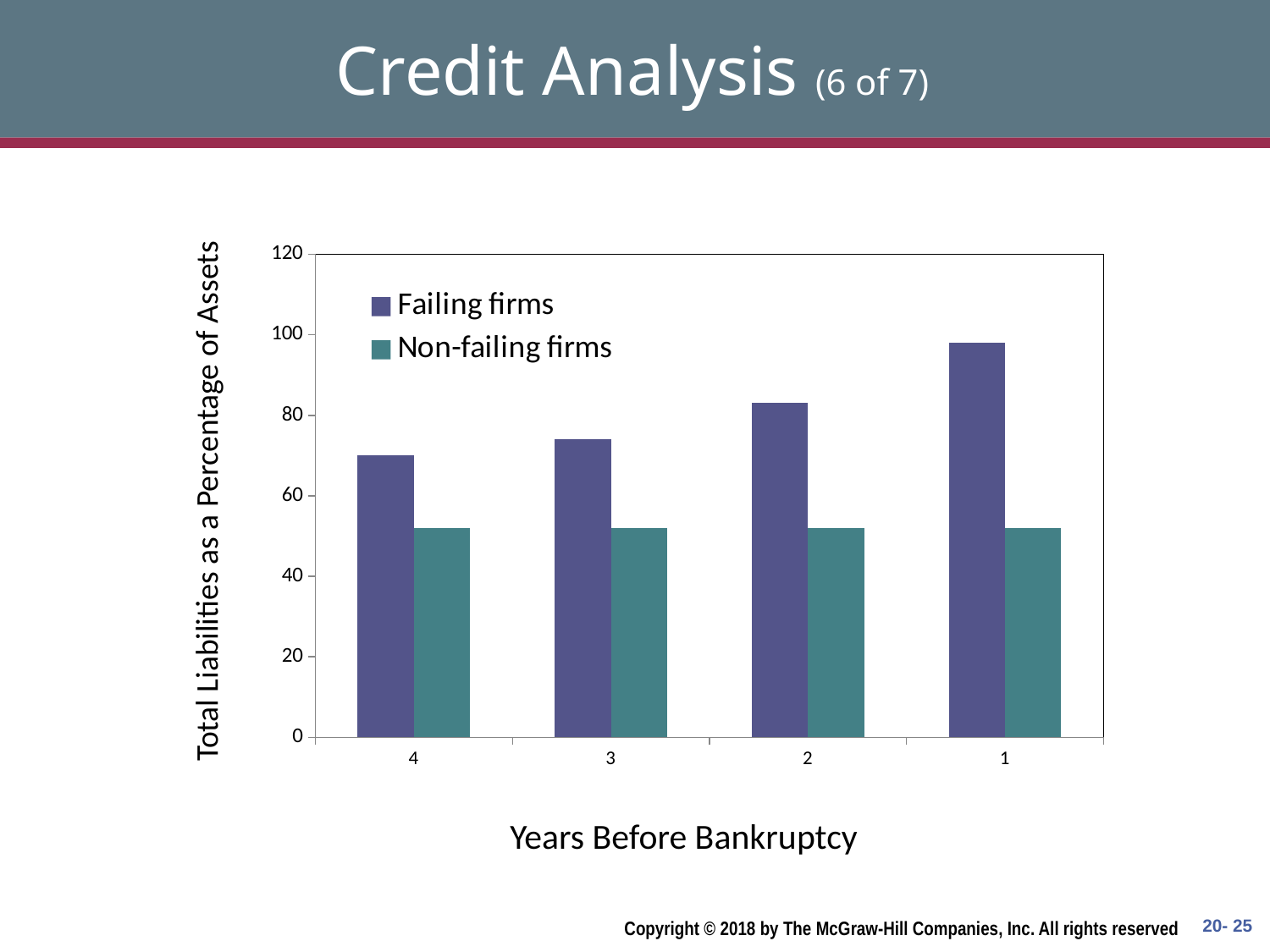
At 2 years before bankruptcy, which series has the larger value, Failing firms or Non-failing firms? Failing firms For Failing firms, which year before bankruptcy has the lowest value? 4 Is the value for Non-failing firms at 4 years before bankruptcy greater or less than 60? less For Failing firms, which year before bankruptcy has the highest value? 1 How many series does the legend list? 2 Which series is shown in the legend first? Failing firms Is the value for Failing firms at 4 years before bankruptcy greater or less than 60? greater What kind of chart is shown on the slide? bar chart What is the title of the x axis? Years Before Bankruptcy How many categories are shown on the x axis? 4 Do the values for Failing firms rise or fall moving from 4 years to 1 year before bankruptcy along the x axis? rise Is the value for Failing firms at 1 year before bankruptcy greater or less than 80? greater